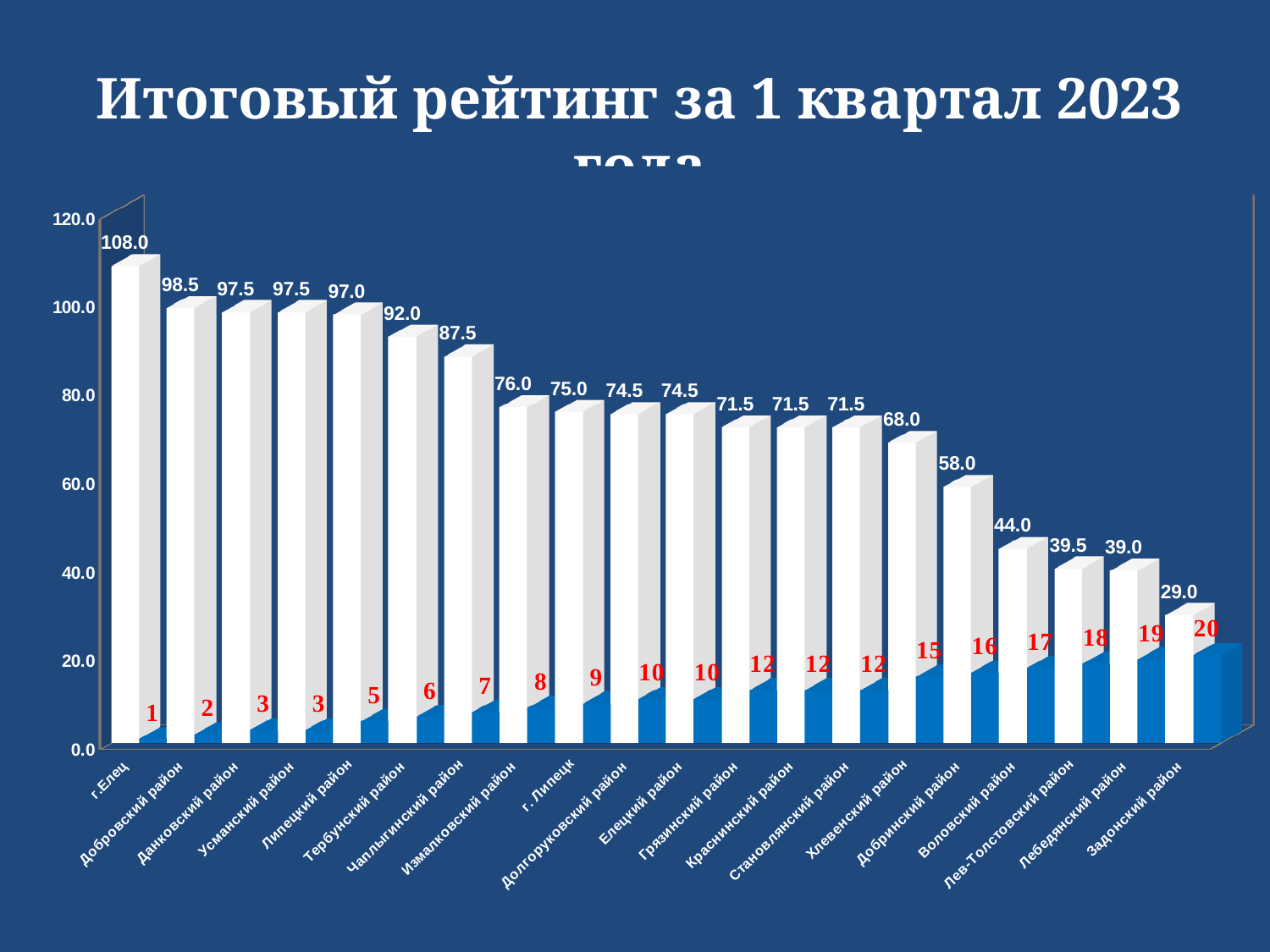
What is the difference between the values for Добринский район and Воловский район? 14.0 What is the value for г.Елец? 108.0 Which category has the lowest value? Задонский район What kind of chart is shown on the slide? Bar chart What is the value for Чаплыгинский район? 87.5 What is the value for Хлевенский район? 68.0 Which is larger, the value for Тербунский район or the value for Измалковский район? Тербунский район Which category has the highest value? г.Елец How many categories are shown on the x axis? 20 What is the difference between the values for г.Елец and Добровский район? 9.5 Do the values rise or fall from left to right along the x axis? Fall What is the value for Задонский район? 29.0